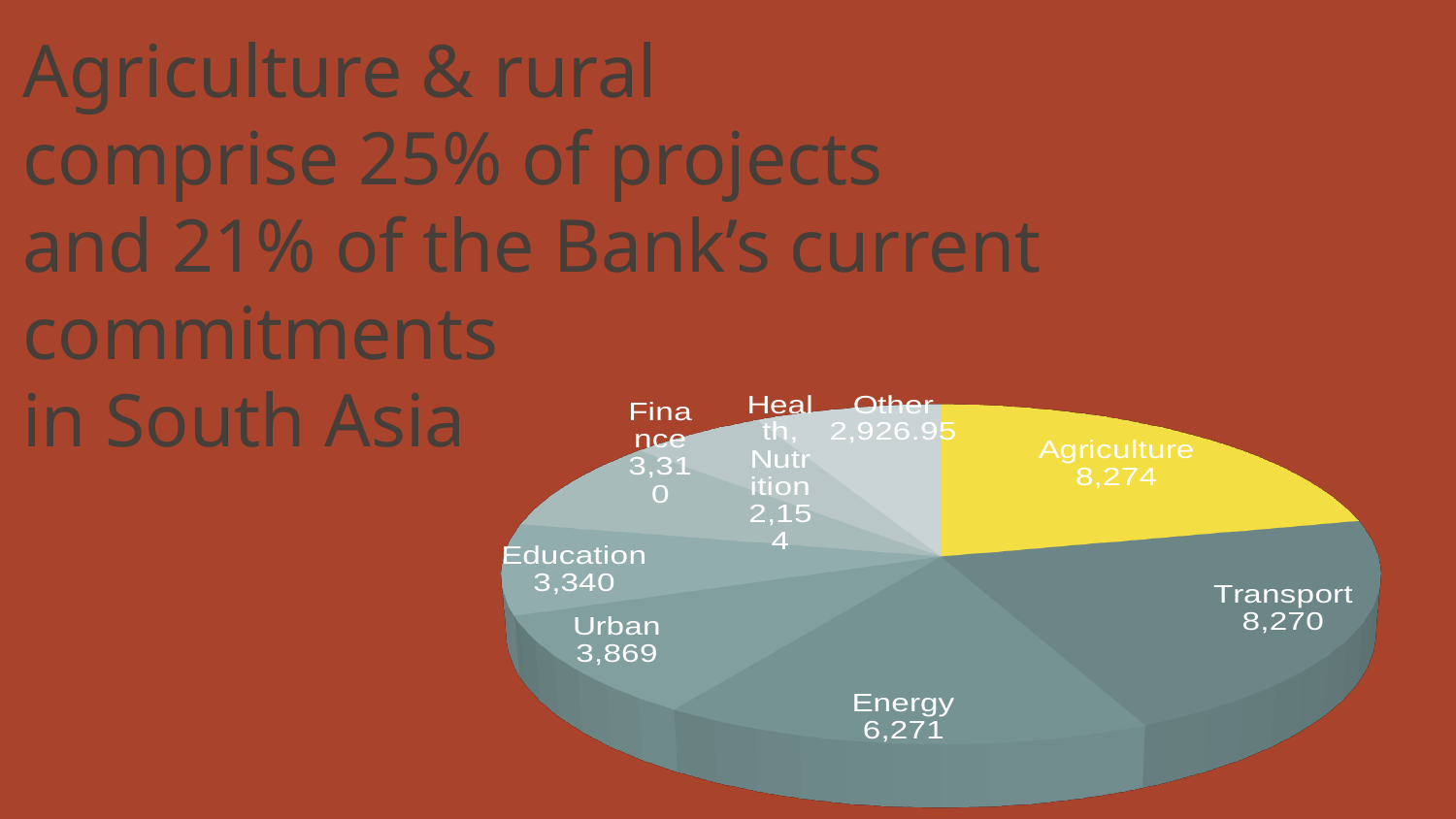
What kind of chart is shown on the slide? Pie chart What is the value shown for Education in the pie chart? 3,340 What is the value shown for Energy in the pie chart? 6,271 What is the value shown for Agriculture in the pie chart? 8,274 What is the difference between the Agriculture value and the Energy value in the pie chart? 2,003 Which is larger in the pie chart, the value for Urban or the value for Education? Urban What is the value shown for Urban in the pie chart? 3,869 What is the value shown for Transport in the pie chart? 8,270 What is the value shown for Finance in the pie chart? 3,310 Which slice of the pie chart is coloured yellow? Agriculture What is the value shown for Health, Nutrition in the pie chart? 2,154 What is the value shown for Other in the pie chart? 2,926.95